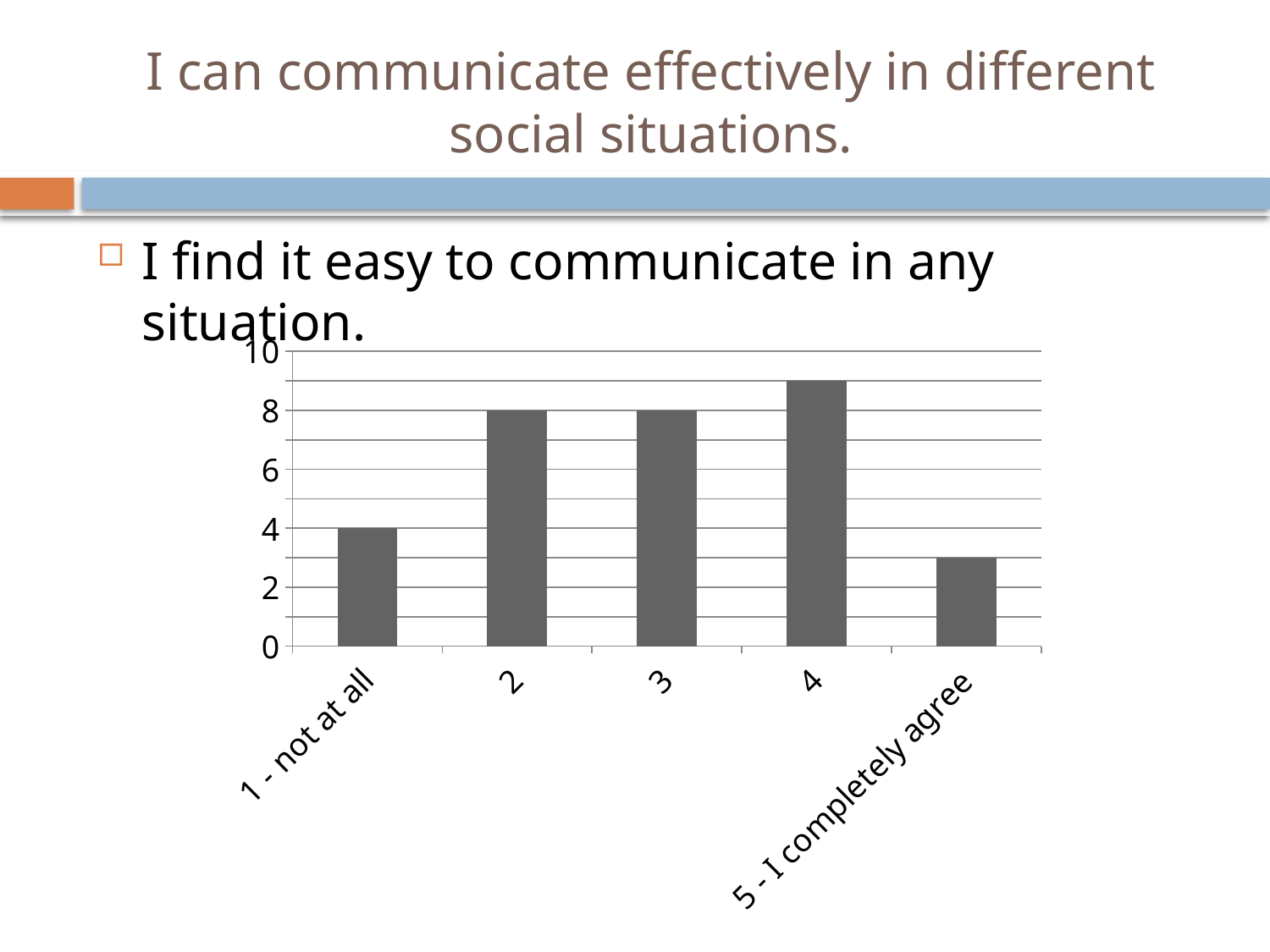
What is the value for category 3? 8 Which is larger, the value for "1 - not at all" or the value for category 2? 2 What is the difference between the values for category 2 and "1 - not at all"? 4 Which category has the lowest bar? 5 - I completely agree Is the value for category 4 greater or less than 8? greater What kind of chart is shown on the slide? bar chart How many categories are shown on the x axis? 5 Is the value for "5 - I completely agree" greater or less than 4? less What is the value for the category "1 - not at all"? 4 What is the value for category 2? 8 Which category has the highest bar? 4 What is the label of the last category on the x axis? 5 - I completely agree